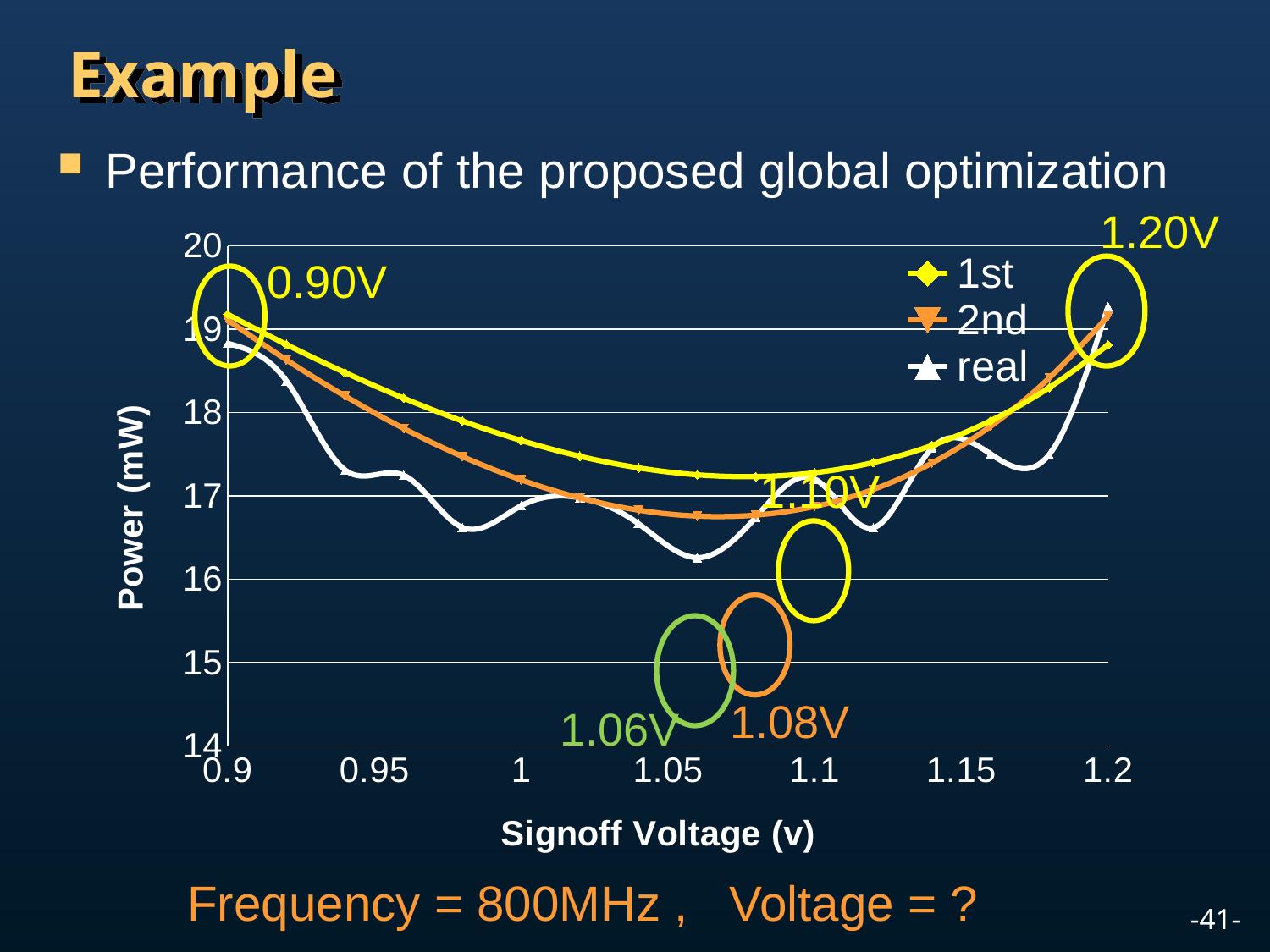
Is the value of the 'real' series at a signoff voltage of 1.06 greater or less than 17? less Does the '1st' series rise or fall as the signoff voltage increases from 0.9 to 1.1? fall What are the names of the series listed in the legend? 1st, 2nd, real How many series does the chart legend list? 3 At a signoff voltage of 1.06, which series has the higher power, 'real' or '2nd'? 2nd At a signoff voltage of 1.0, which series has the higher power, '1st' or '2nd'? 1st What kind of chart is shown on the slide? line chart Is the value of the '1st' series at a signoff voltage of 1.1 greater or less than 17? greater What is the title of the y axis of the chart? Power (mW) Is the value of the '1st' series at a signoff voltage of 1.2 greater or less than 19? less Which series reaches the lowest power value on the chart? real